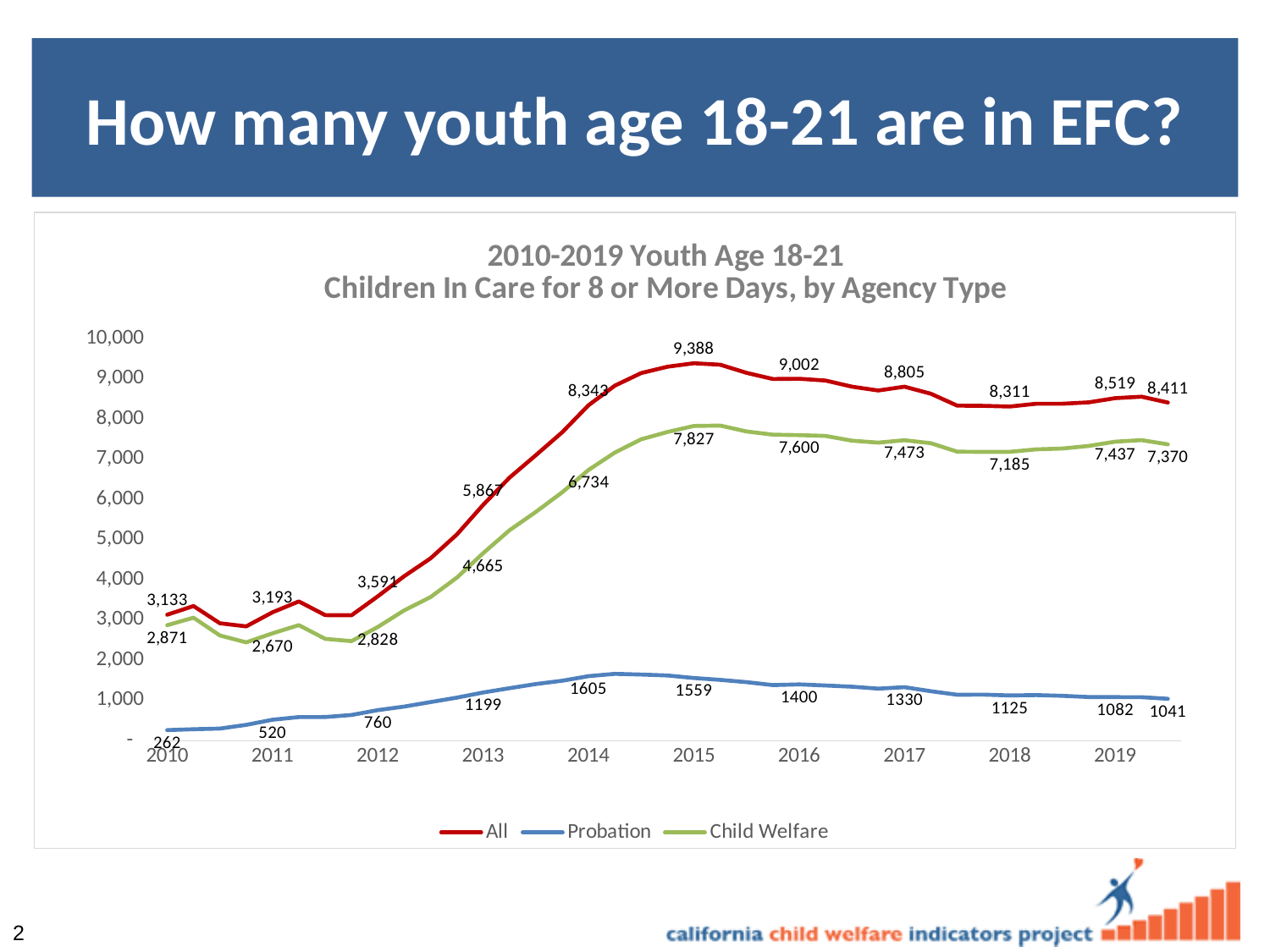
In which year does the Probation series have its lowest labeled value? 2010 In which year does the All series reach its highest labeled value? 2015 How many series does the legend list? 3 What colour is the line for the Child Welfare series? Green What type of chart is shown on the slide? Line chart What is the value of the Probation series in 2014? 1605 What is the difference between the All value and the Child Welfare value in 2015? 1,561 Does the Probation series rise or fall from 2010 to 2014? Rise What is the value of the All series in 2015? 9,388 Which is larger: the Child Welfare value in 2016 or the Child Welfare value in 2018? 2016 What is the value of the Child Welfare series in 2013? 4,665 Is the All value in 2012 greater or less than 4,000? less